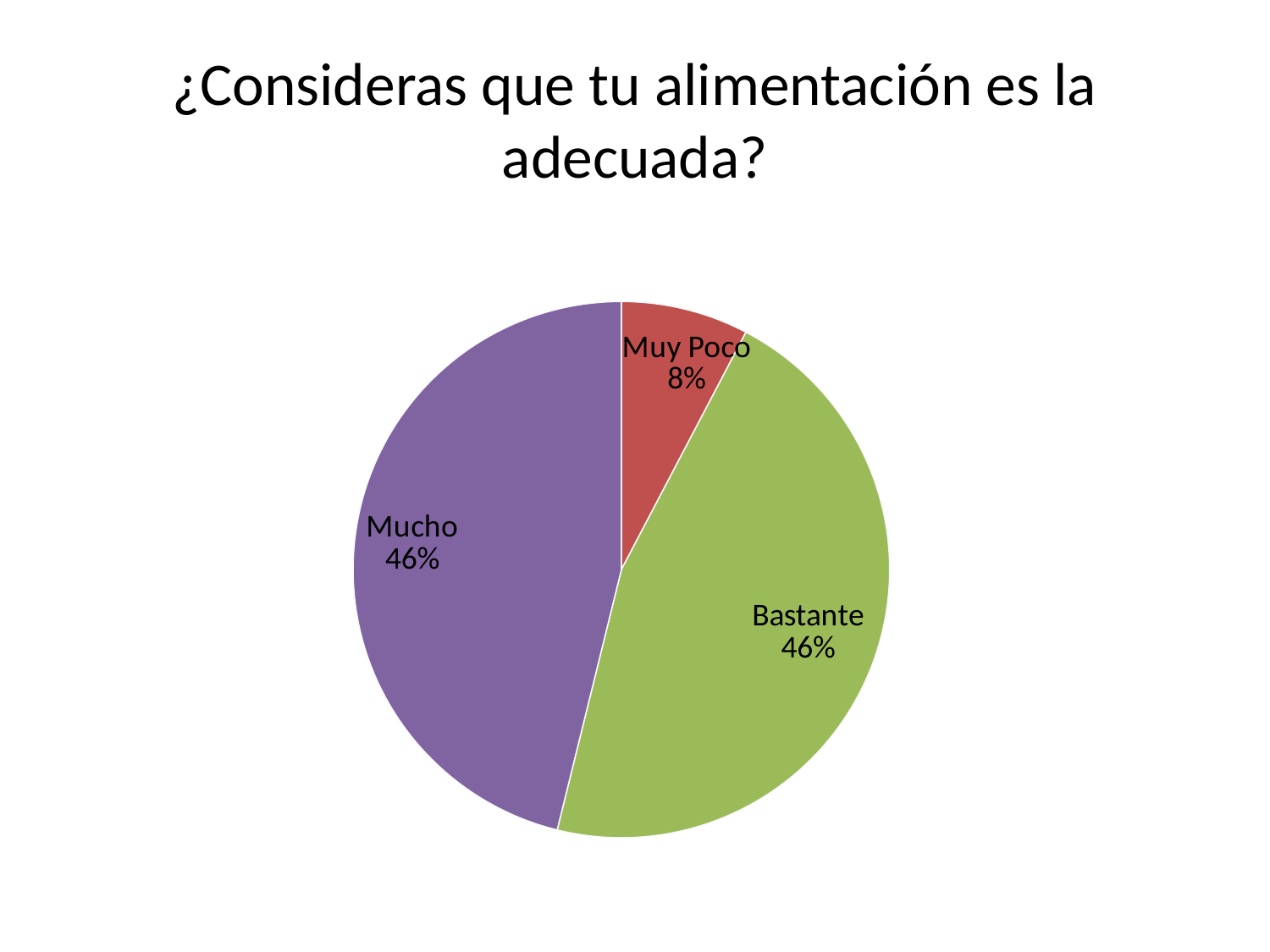
Which category has the smallest slice of the pie? Muy Poco What is the title of the chart? ¿Consideras que tu alimentación es la adecuada? What colour is the Muy Poco slice? red What kind of chart is shown on the slide? pie chart What share of the pie does the Mucho slice represent? 46% What share of the pie does the Muy Poco slice represent? 8% What is the difference in percentage points between the Bastante slice and the Muy Poco slice? 38 What share of the pie does the Bastante slice represent? 46% How many slices does the pie chart have? 3 Which is larger, the Mucho slice or the Muy Poco slice? Mucho What is the combined share of the Bastante and Mucho slices? 92%